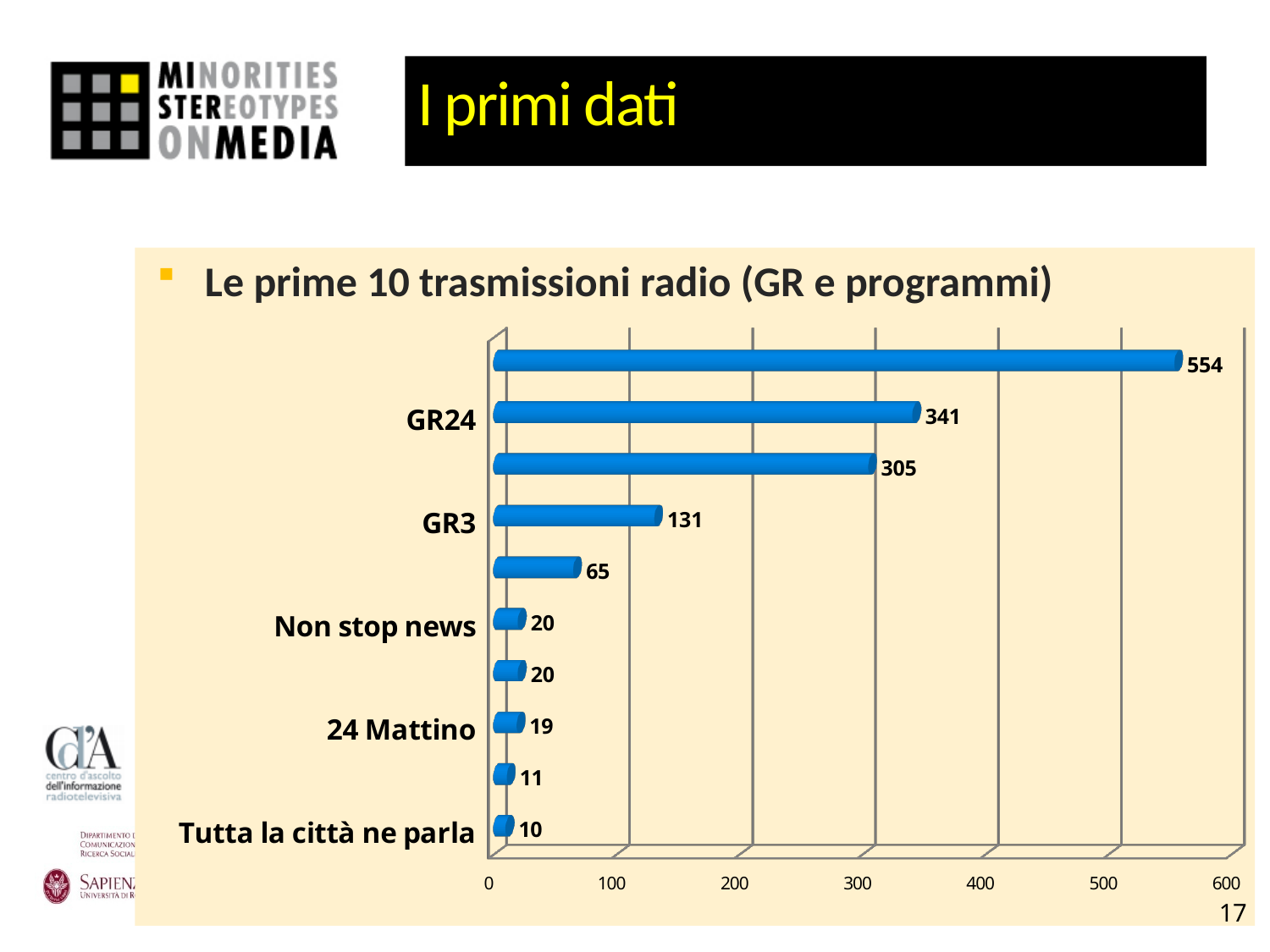
What is the value for GR3? 131 Which is larger, the value for GR24 or the value for GR3? GR24 What is the value for 24 Mattino? 19 What is the value for Tutta la città ne parla? 10 What is the title of the chart? Le prime 10 trasmissioni radio (GR e programmi) What is the highest value shown in the chart? 554 What is the difference between the values for GR24 and GR3? 210 What type of chart is shown on the slide? bar chart What is the value for GR24? 341 What is the value for Non stop news? 20 How many bars are plotted in the chart? 10 Which labelled category has the lowest value? Tutta la città ne parla